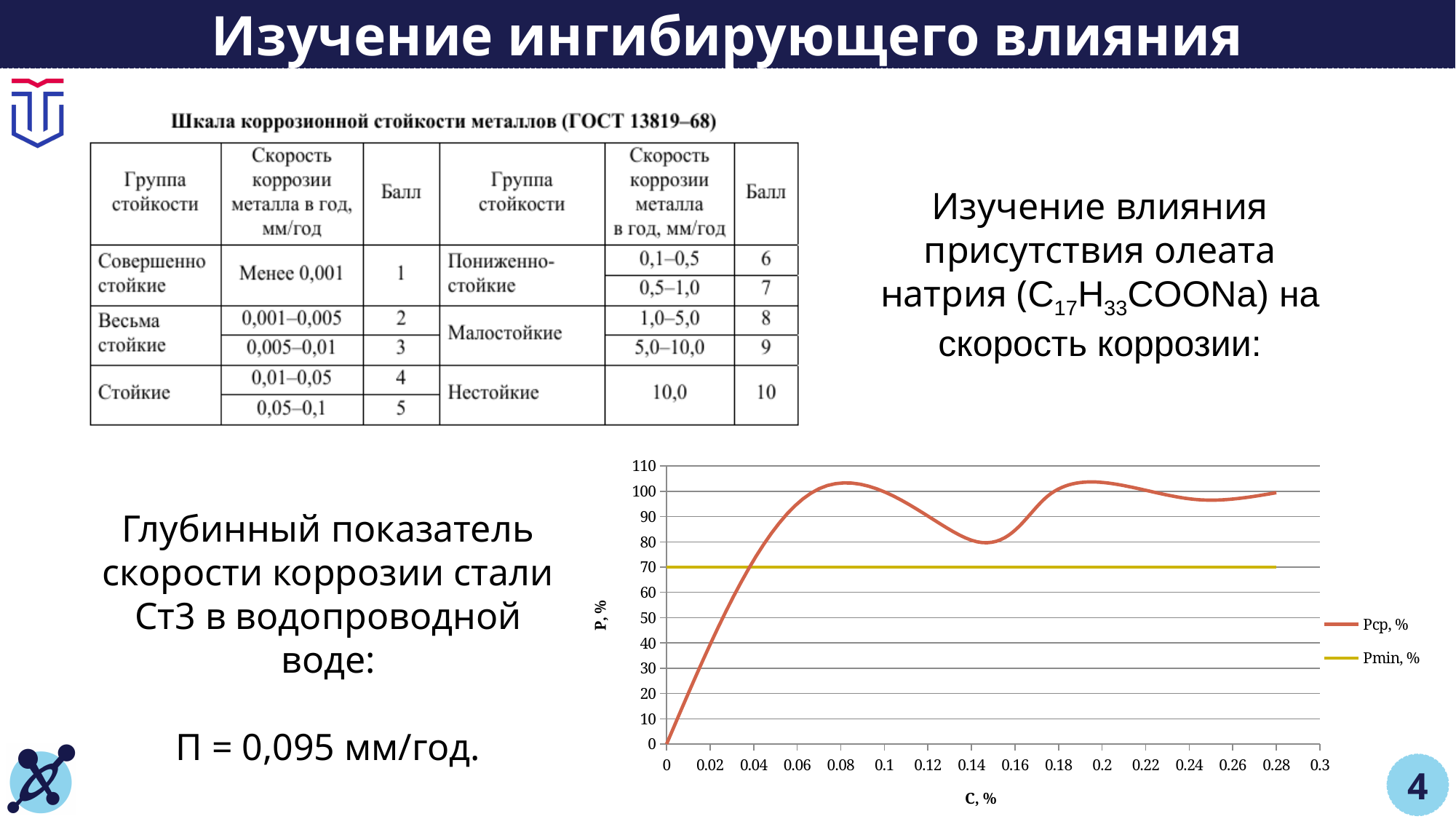
What is the value of the Pmin, % series across the chart? 70 Which series has the larger value at C = 0.2, Pср, % or Pmin, %? Pср, % Does the Pср, % series rise or fall between C = 0 and C = 0.08? rise What is the label of the x axis of the chart? C, % What is the value of Pср, % at C = 0? 0 Is the value of Pср, % at C = 0.08 greater or less than 100? greater Is the value of Pср, % at C = 0.15 greater or less than 90? less Is the value of Pср, % at C = 0.02 greater or less than 70? less What kind of chart is shown on the slide? line chart How many series does the chart legend list? 2 What are the two series named in the chart legend? Pср, % and Pmin, %